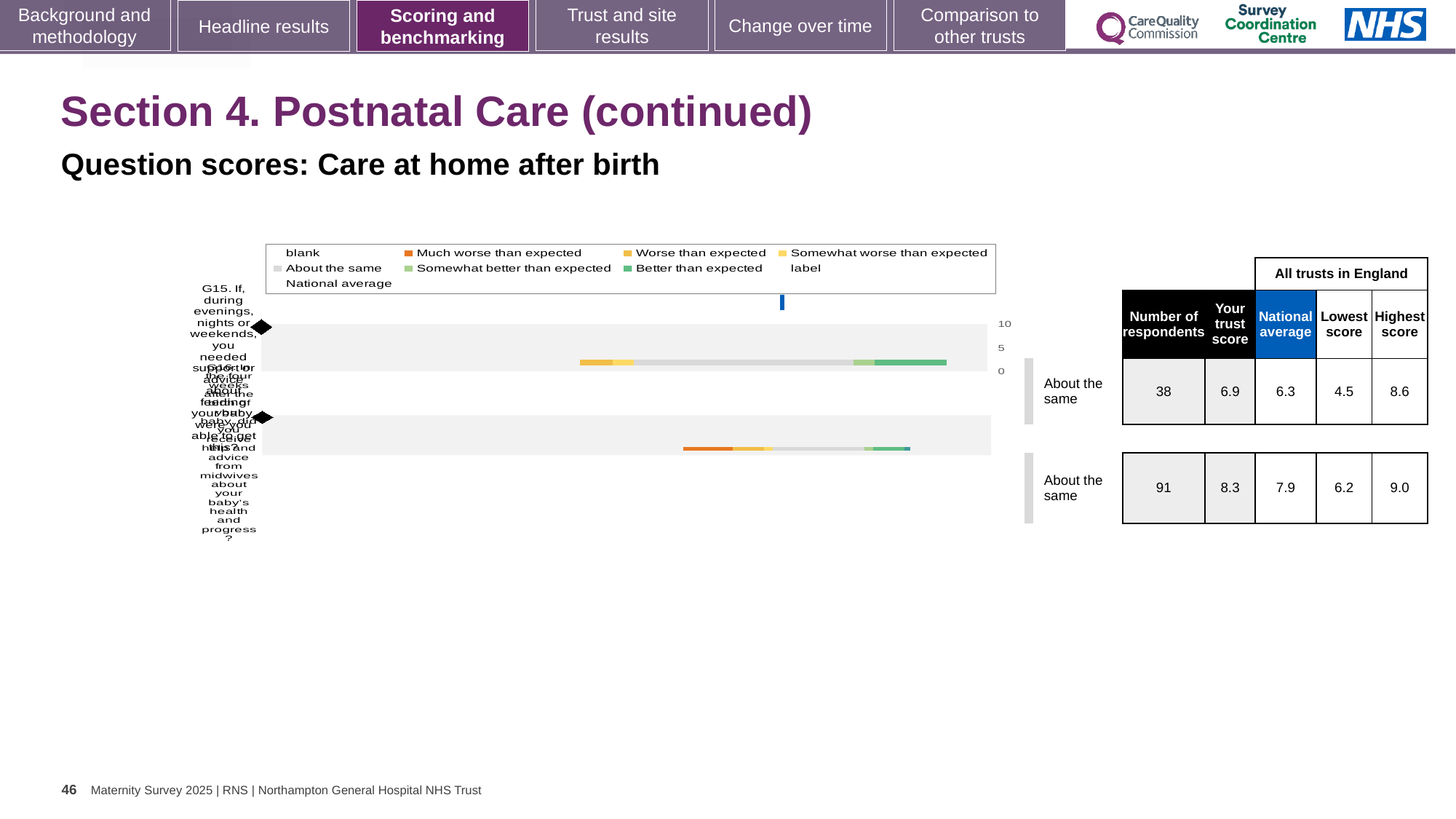
What is the 'Your trust score' for the top row of the chart? 6.9 What is the benchmark category shown next to both rows of the chart? About the same Which row has the higher 'Your trust score', the top row or the bottom row? bottom row What is the 'Highest score' for the bottom row of the chart? 9.0 What kind of chart is shown on the slide? bar chart What is the 'Lowest score' for the top row of the chart? 4.5 What is the 'National average' for the top row of the chart? 6.3 What is the difference between the trust score and the national average for the bottom row? 0.4 What is the 'Your trust score' for the bottom row of the chart? 8.3 How many respondents are listed for the top row of the chart? 38 What colour does the legend use for 'Much worse than expected'? orange How many question rows (bars) are plotted in the chart? 2